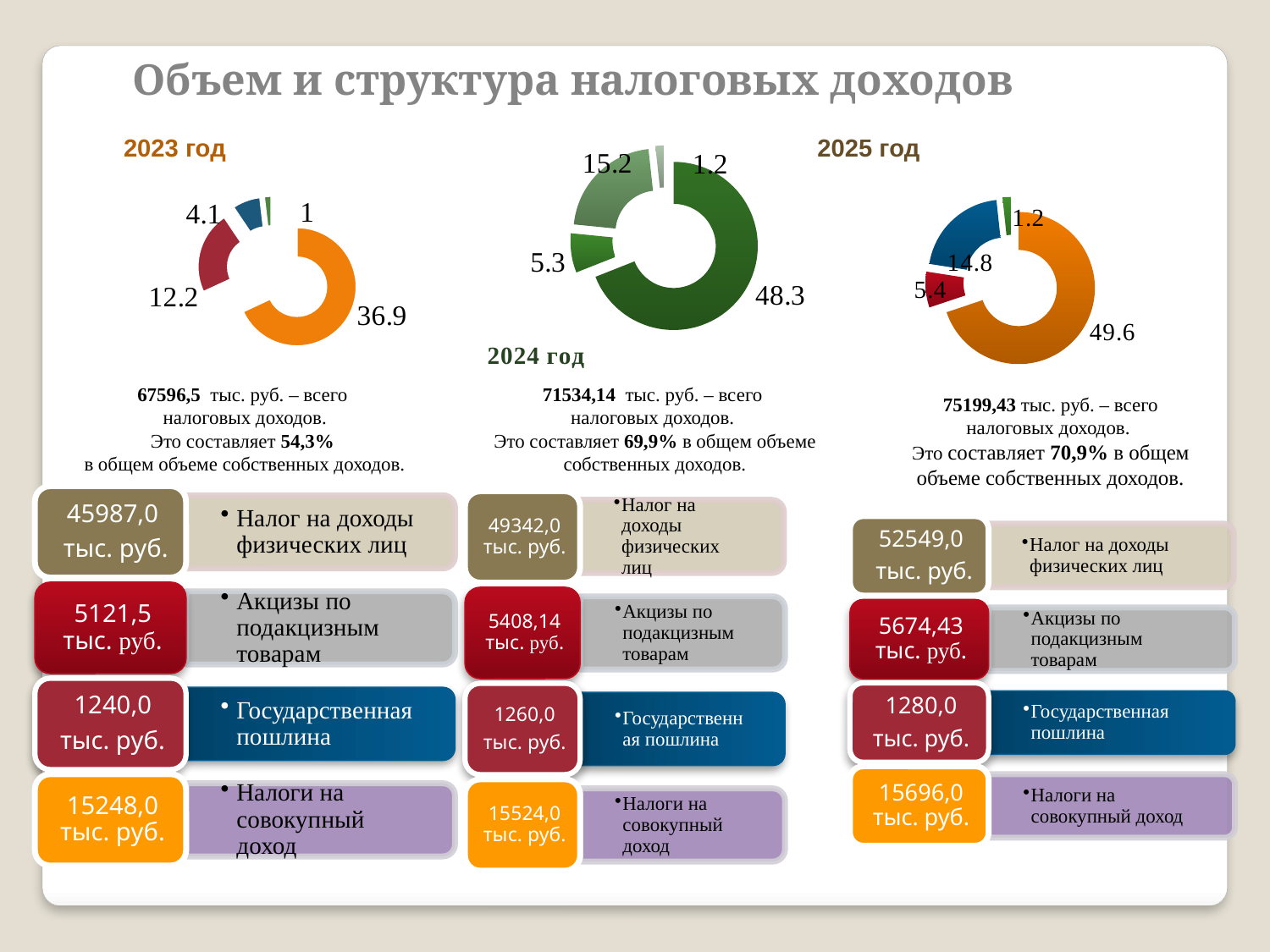
In the 2023 год chart, what is the value of the second-largest slice? 12.2 In the 2025 год chart, what is the value of the largest slice? 49.6 In the 2023 год chart, what is the value of the smallest labelled slice? 1 How many labelled slices does the 2024 год chart have? 4 What is the title of the slide containing the three doughnut charts? Объем и структура налоговых доходов In the 2024 год chart, what is the value of the smallest slice? 1.2 In the 2024 год chart, what is the value of the largest slice? 48.3 In the 2024 год chart, what is the difference between the largest slice (48.3) and the second-largest slice (15.2)? 33.1 What kind of chart is used for the 2023 год data? doughnut chart Which is larger: the largest slice of the 2025 год chart or the largest slice of the 2024 год chart? 2025 год (49.6) In the 2023 год chart, what is the value of the largest slice? 36.9 In the 2025 год chart, what is the difference between the slices labelled 14.8 and 5.4? 9.4